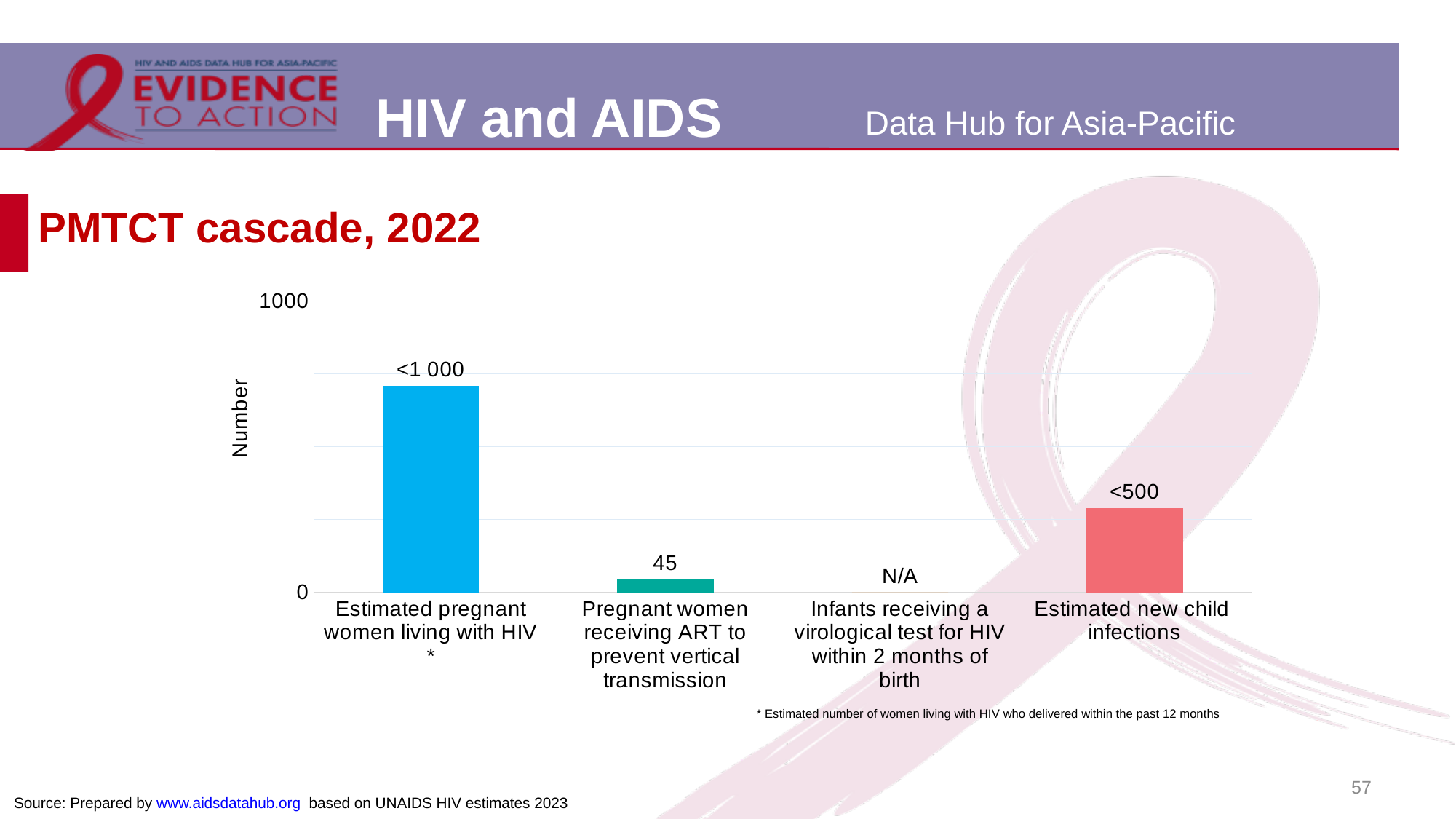
How many categories are shown on the x axis? 4 What kind of chart is shown on the slide? bar chart What is the title of the chart? PMTCT cascade, 2022 Is the value for Estimated new child infections greater or less than 500? less Which is larger: the value for Estimated pregnant women living with HIV or the value for Estimated new child infections? Estimated pregnant women living with HIV What value is shown for Estimated new child infections? <500 Which category with a plotted bar has the lowest value? Pregnant women receiving ART to prevent vertical transmission What value is shown for Infants receiving a virological test for HIV within 2 months of birth? N/A Which category has the tallest bar? Estimated pregnant women living with HIV What is the label of the vertical axis? Number What value is shown for Pregnant women receiving ART to prevent vertical transmission? 45 What value is shown for Estimated pregnant women living with HIV? <1 000